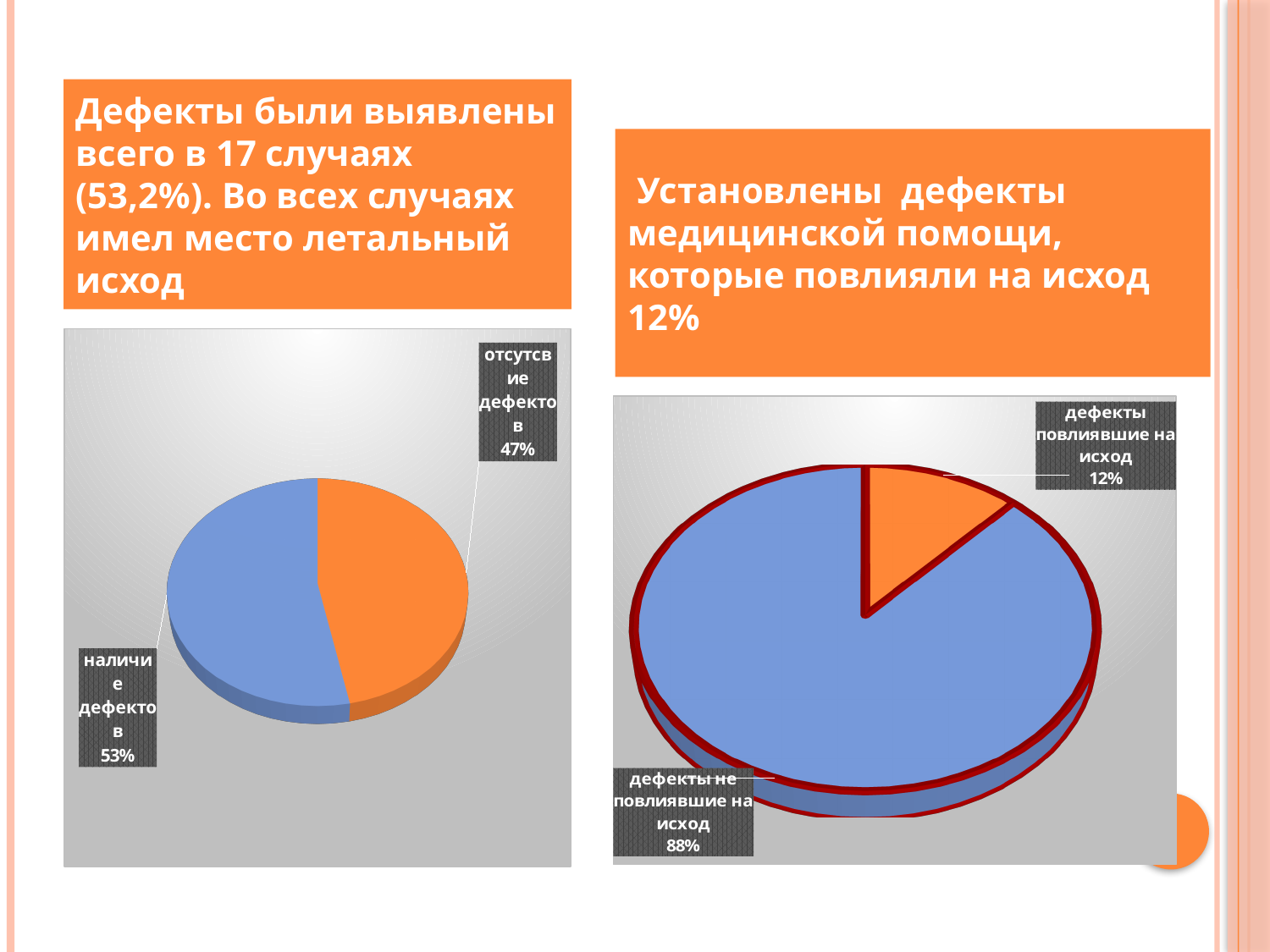
On the right pie chart, what share is labelled for "дефекты не повлиявшие на исход"? 88% On the right pie chart, which is larger: "дефекты повлиявшие на исход" or "дефекты не повлиявшие на исход"? дефекты не повлиявшие на исход On the left pie chart, what is the difference in percentage points between "наличие дефектов" and "отсутсвие дефектов"? 6 On the right pie chart, what share is labelled for "дефекты повлиявшие на исход"? 12% What type of chart is shown on the right side of the slide? pie chart On the right pie chart, which slice is the smallest? дефекты повлиявшие на исход On the right pie chart, what colour is the "дефекты повлиявшие на исход" slice? orange On the left pie chart, what share is labelled for "отсутсвие дефектов"? 47% On the left pie chart, which slice is the largest? наличие дефектов On the right pie chart, what is the difference in percentage points between "дефекты не повлиявшие на исход" and "дефекты повлиявшие на исход"? 76 How many slices does the left pie chart have? 2 On the left pie chart, what share is labelled for "наличие дефектов"? 53%